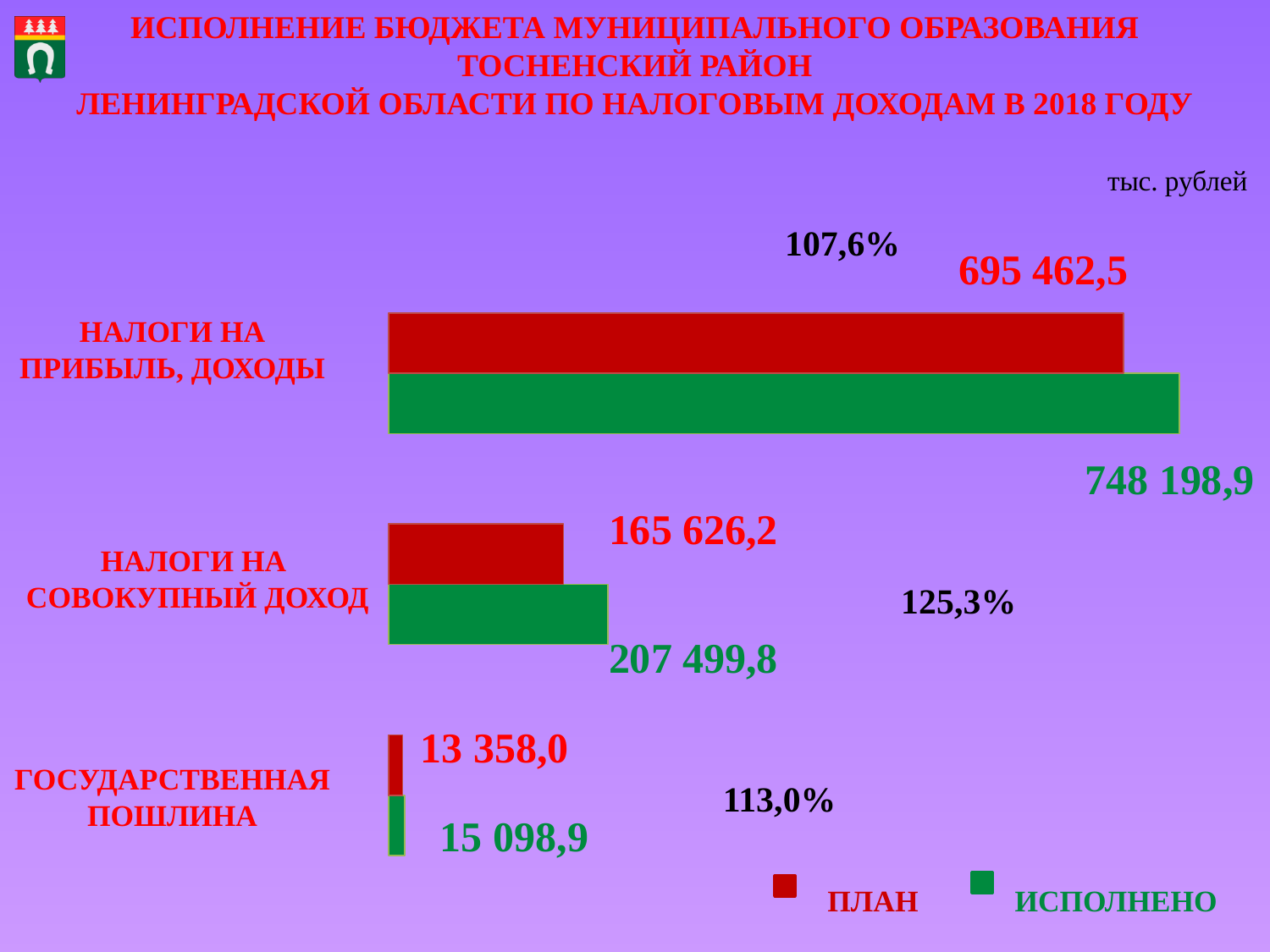
Which category has the highest ИСПОЛНЕНО value? НАЛОГИ НА ПРИБЫЛЬ, ДОХОДЫ What is the ИСПОЛНЕНО value for ГОСУДАРСТВЕННАЯ ПОШЛИНА? 15 098,9 What type of chart is shown on the slide? Bar chart Which category has the lowest ПЛАН value? ГОСУДАРСТВЕННАЯ ПОШЛИНА How many series does the legend list? 2 What is the difference between the ИСПОЛНЕНО and ПЛАН values for НАЛОГИ НА ПРИБЫЛЬ, ДОХОДЫ? 52 736,4 What percentage is shown for НАЛОГИ НА СОВОКУПНЫЙ ДОХОД? 125,3% What is the ИСПОЛНЕНО value for НАЛОГИ НА СОВОКУПНЫЙ ДОХОД? 207 499,8 What unit is stated for the values in the chart? тыс. рублей For ГОСУДАРСТВЕННАЯ ПОШЛИНА, which is larger: the ПЛАН value or the ИСПОЛНЕНО value? ИСПОЛНЕНО How many categories are shown in the chart? 3 What is the ПЛАН value for НАЛОГИ НА ПРИБЫЛЬ, ДОХОДЫ? 695 462,5